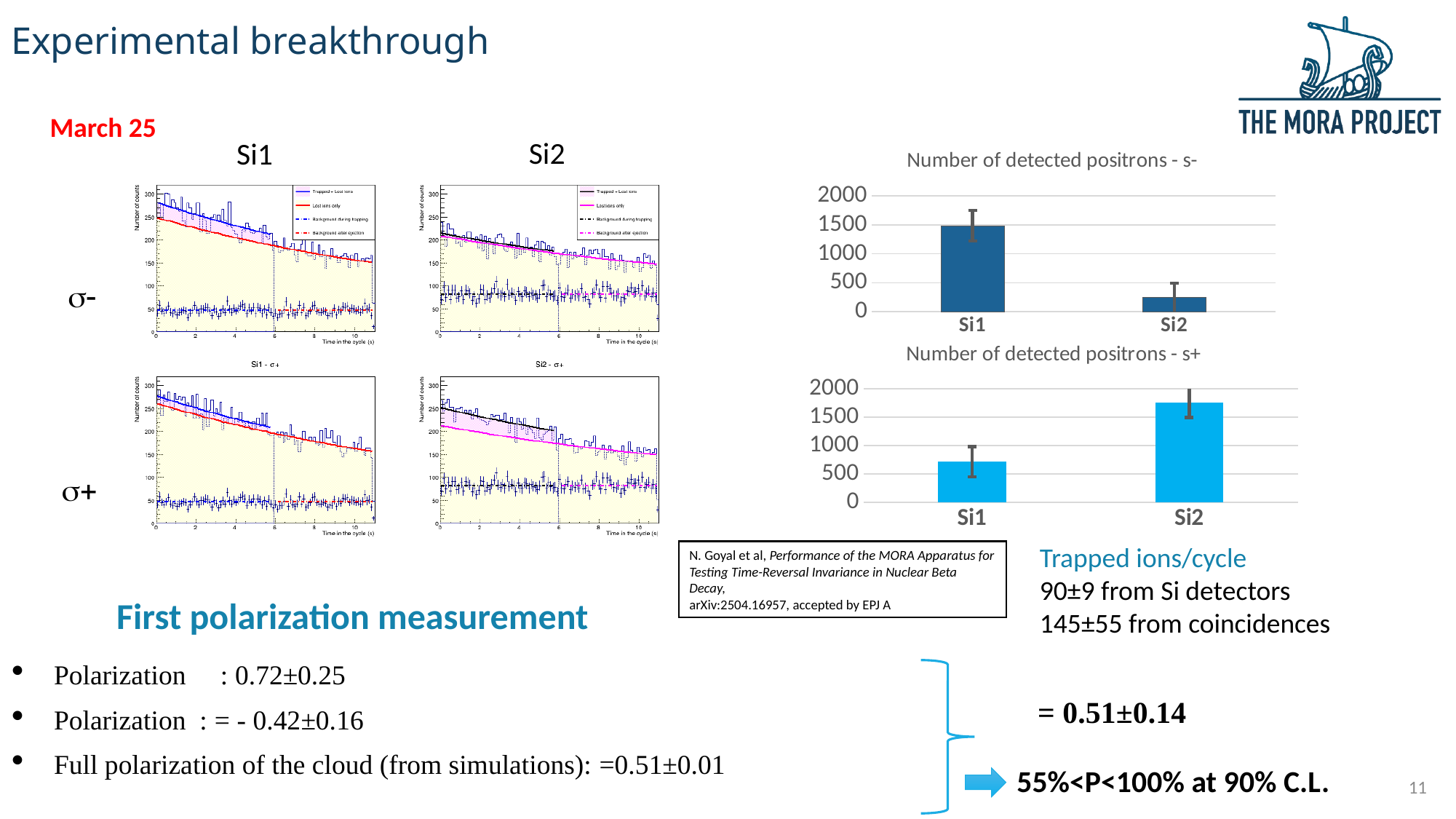
In the chart titled "Number of detected positrons - s-", is the value for Si2 greater or less than 500? less In the chart titled "Number of detected positrons - s+", which category has the highest value? Si2 In the chart titled "Number of detected positrons - s-", is the value for Si1 greater or less than 1000? greater What is the title of the upper bar chart on the right side of the slide? Number of detected positrons - s- In the chart titled "Number of detected positrons - s-", which category has the highest value? Si1 In the chart titled "Number of detected positrons - s+", which is larger, the value for Si1 or the value for Si2? Si2 How many categories are shown on the x axis of the chart titled "Number of detected positrons - s-"? 2 What kind of chart is the chart titled "Number of detected positrons - s+"? bar chart In the chart titled "Number of detected positrons - s+", which category has the lowest value? Si1 In the chart titled "Number of detected positrons - s+", is the value for Si2 greater or less than 1500? greater In the chart titled "Number of detected positrons - s-", which category has the lowest value? Si2